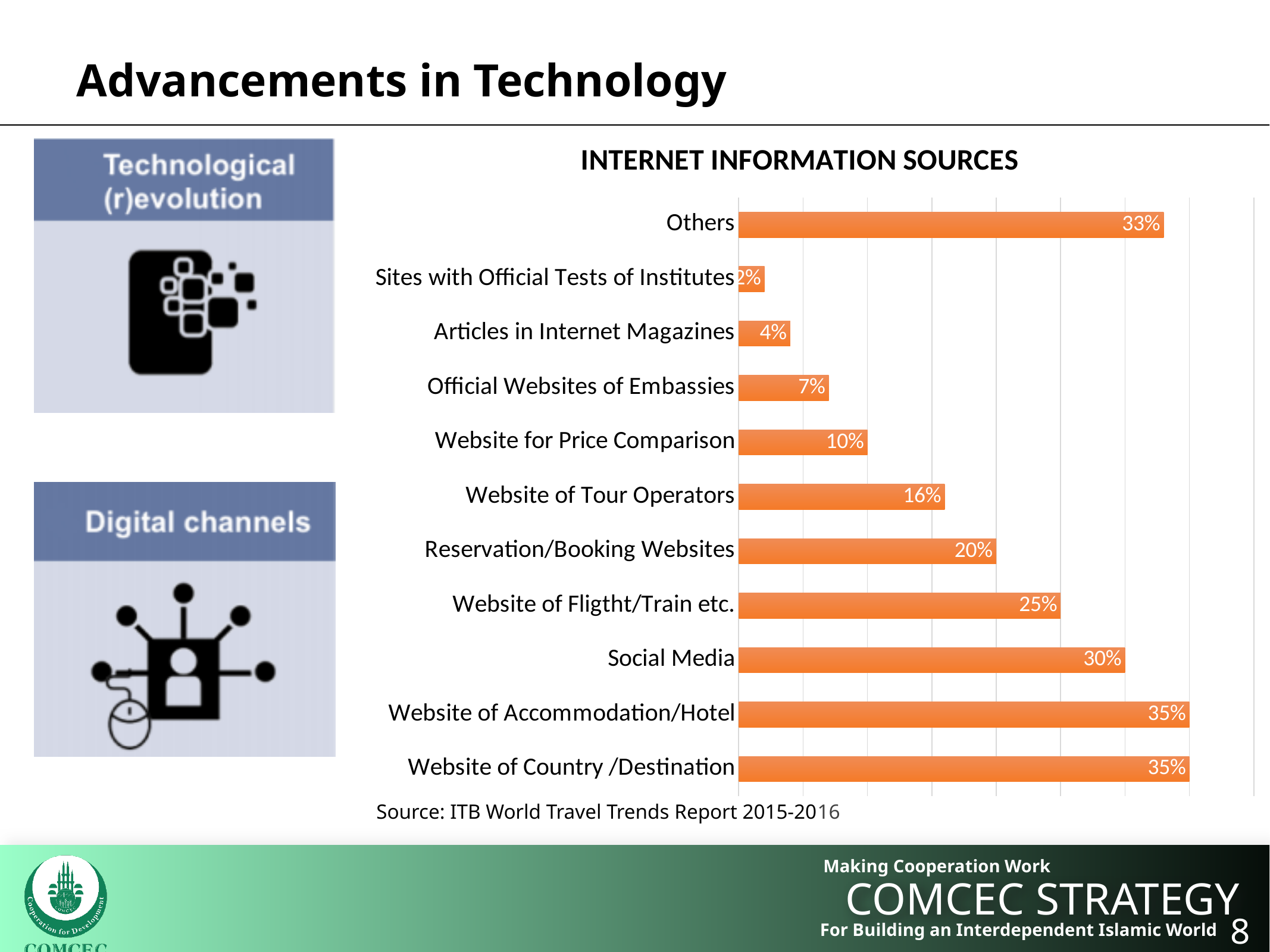
Which is larger, Articles in Internet Magazines or Official Websites of Embassies? Official Websites of Embassies What is the difference between the values for Website of Accommodation/Hotel and Social Media? 5% What is the value for Official Websites of Embassies? 7% How many categories are shown in the Internet Information Sources chart? 11 Which is larger, the value for Others or the value for Social Media? Others What is the source cited below the chart? ITB World Travel Trends Report 2015-2016 What value is shown for Reservation/Booking Websites? 20% What kind of chart is used to show the Internet Information Sources? Bar chart What is the value for Social Media in the Internet Information Sources chart? 30% What percentage is shown for Website of Tour Operators? 16% Which category has the lowest value in the chart? Sites with Official Tests of Institutes What is the difference between Website of Flight/Train etc. and Website for Price Comparison? 15%